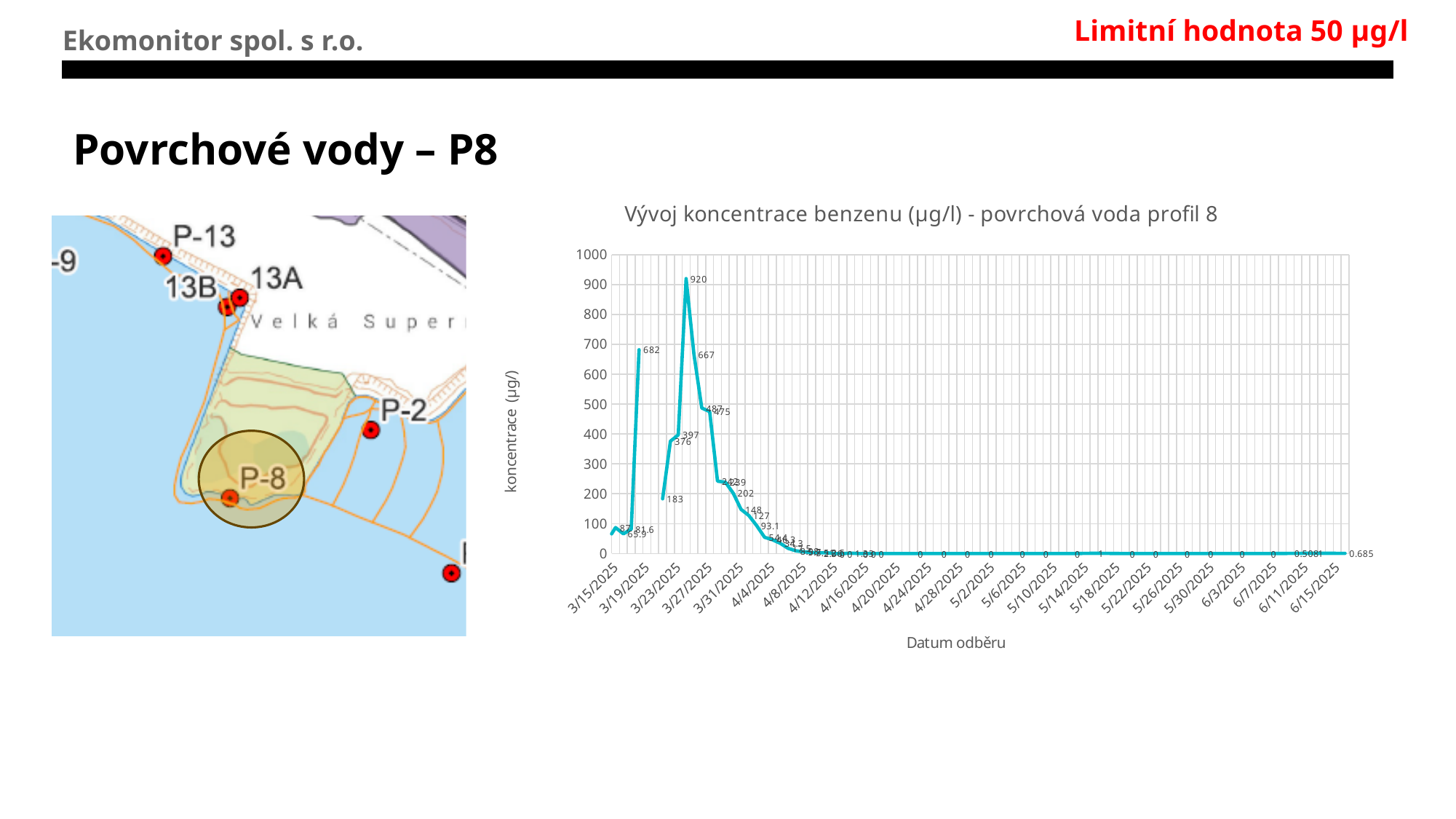
What is the highest data label shown on the chart? 920 Is the value labelled 183 greater or less than 200? less What is the title of the chart? Vývoj koncentrace benzenu (µg/l) - povrchová voda profil 8 What is the difference between the labelled values 397 and 376? 21 Which is larger, the labelled value 682 or the labelled value 667? 682 What is the data label on the last point at the right end of the line (6/15/2025)? 0.685 After the peak at 920, do the values rise or fall along the x axis? fall What kind of chart is shown on the slide? line chart Is the peak value of the line greater or less than 900? greater What is the difference between the peak value 920 and the earlier labelled value 682? 238 What is the label of the x axis? Datum odběru What is the maximum value shown on the y axis? 1000